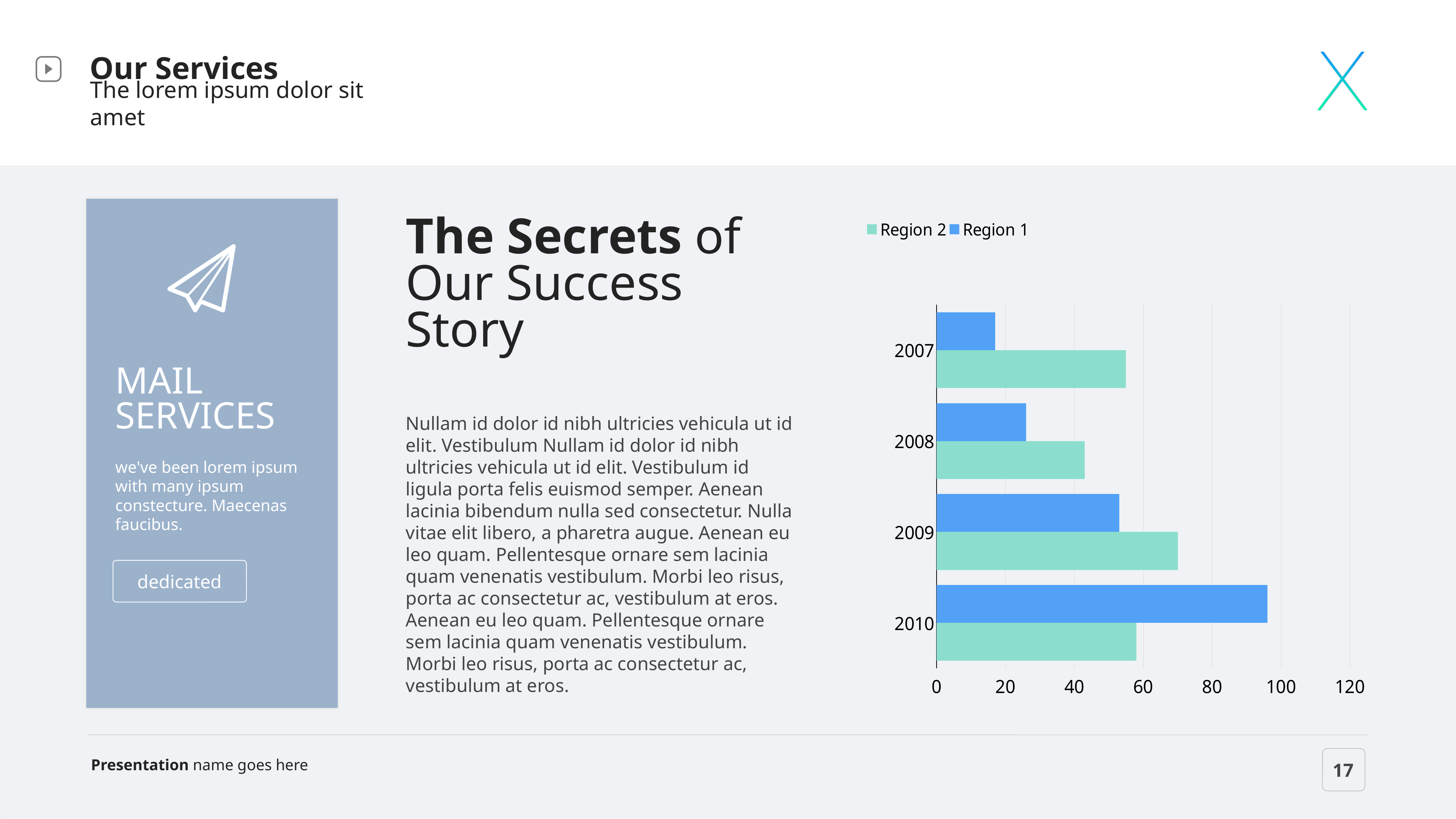
Is the value for Region 1 in 2007 greater or less than 20? less Which year has the highest value for Region 1? 2010 Which year has the highest value for Region 2? 2009 Is the value for Region 1 in 2010 greater or less than 80? greater What kind of chart is shown on the slide? bar chart Which year has the lowest value for Region 1? 2007 In 2010, which series has the larger value, Region 1 or Region 2? Region 1 How many years are shown on the chart's category axis? 4 In 2007, which series has the larger value, Region 1 or Region 2? Region 2 How many series does the chart's legend list? 2 Which year has the lowest value for Region 2? 2008 Do the Region 1 values rise or fall from 2007 to 2010? rise